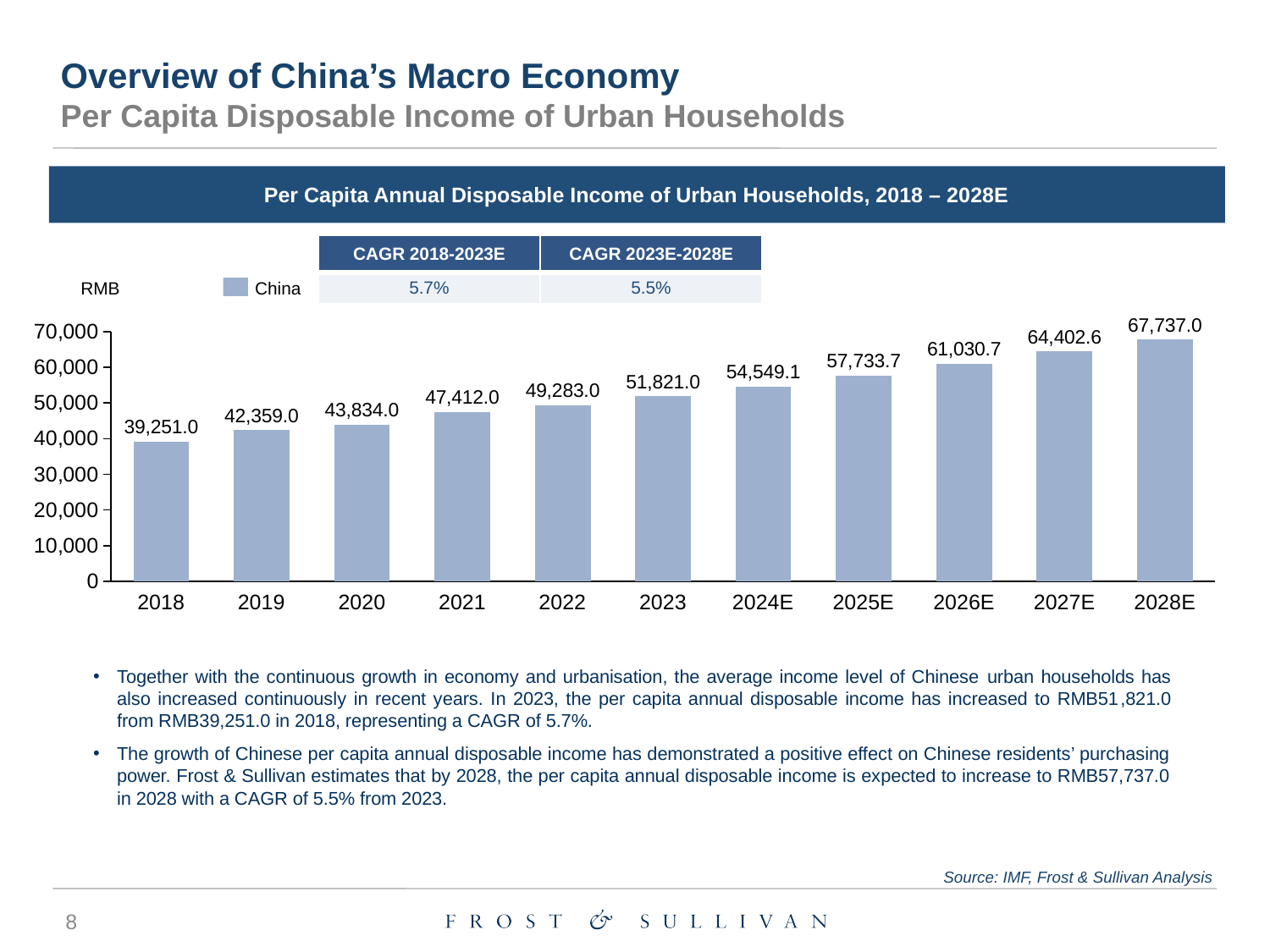
Which year has the highest value in the chart? 2028E What kind of chart is shown on the slide? bar chart Is the value for 2026E greater or less than 60,000? greater How many years are shown on the x axis of the chart? 11 What is the difference between the values for 2023 and 2018? 12,570.0 What is the value shown for 2023? 51,821.0 Which is larger, the value for 2022 or the value for 2024E? 2024E Do the values rise or fall from 2018 to 2028E? rise What is the per capita annual disposable income of urban households in 2018? 39,251.0 What is the value shown for 2028E? 67,737.0 Which year has the lowest value in the chart? 2018 What is the value shown for 2025E? 57,733.7